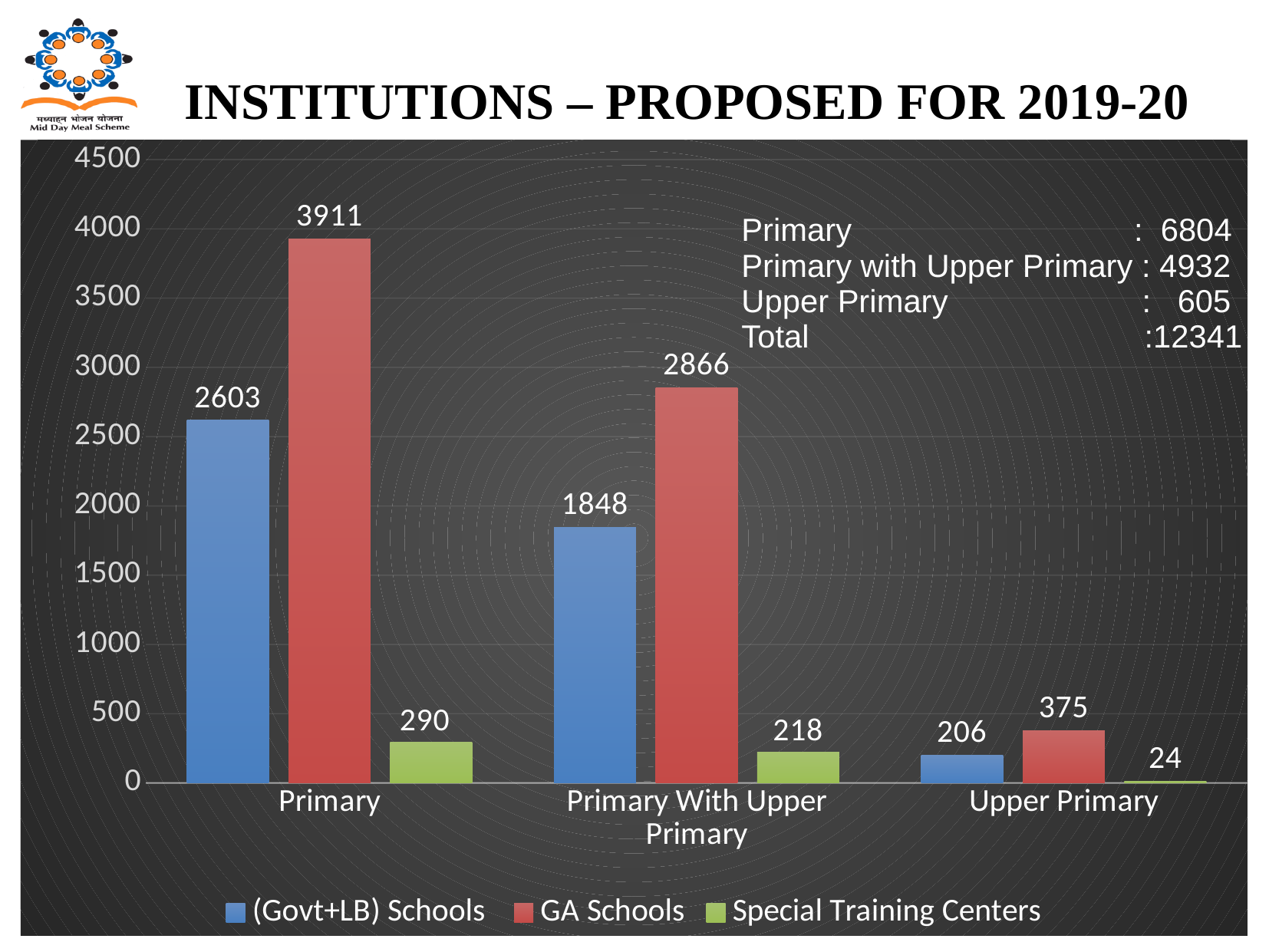
Which category has the lowest value for (Govt+LB) Schools? Upper Primary What is the value for (Govt+LB) Schools in the Primary With Upper Primary category? 1848 What is the value for Special Training Centers in the Upper Primary category? 24 How many series does the legend list? 3 What is the difference between GA Schools and (Govt+LB) Schools in the Primary category? 1308 Which is larger in the Upper Primary category: (Govt+LB) Schools or GA Schools? GA Schools What kind of chart is shown on the slide? bar chart What is the value for GA Schools in the Primary category? 3911 How many categories are shown on the x axis? 3 Which colour represents Special Training Centers in the legend? green Which category has the highest value for GA Schools? Primary Is the value for GA Schools in the Primary With Upper Primary category greater or less than 3000? less